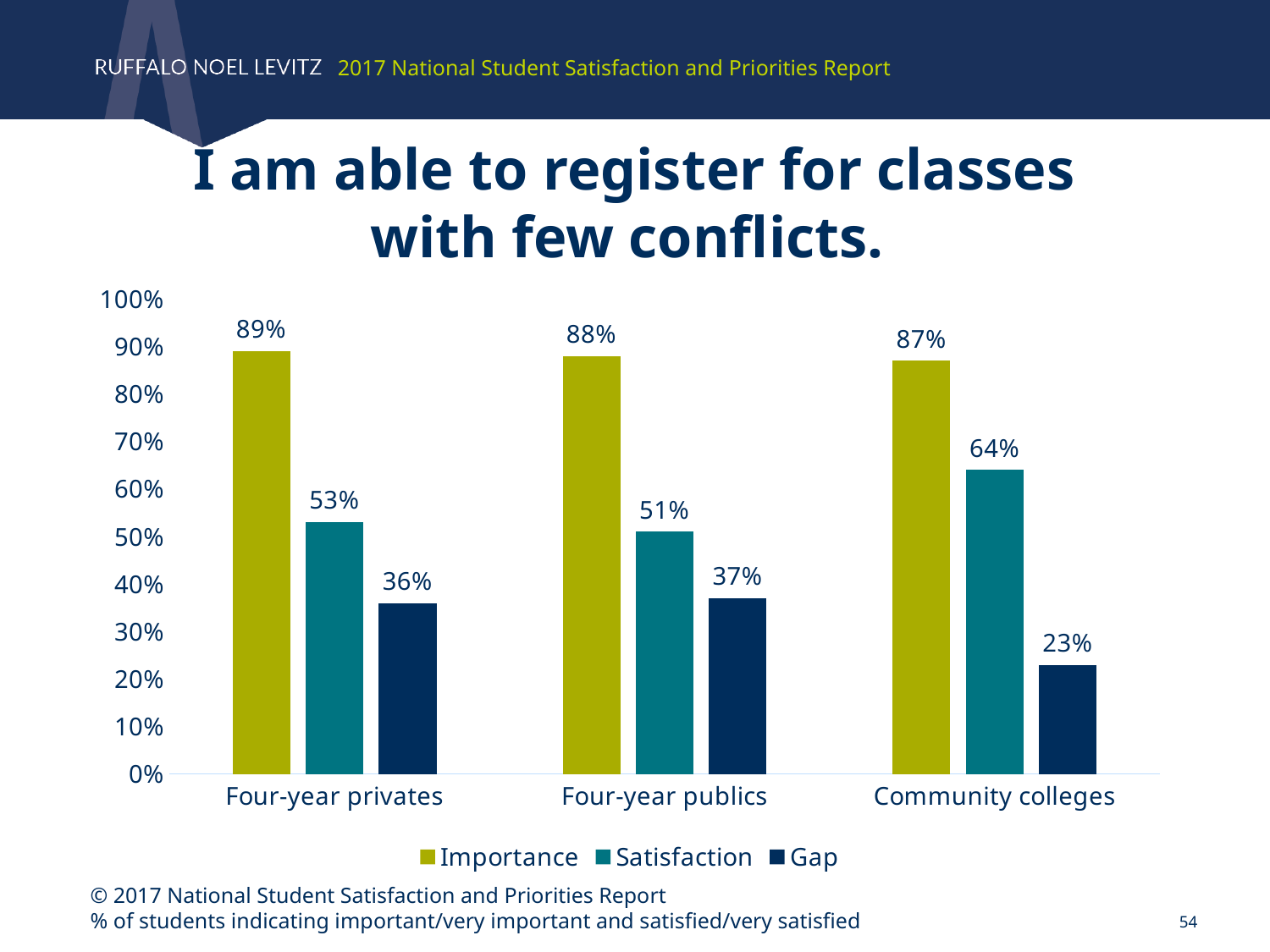
What kind of chart is shown on the slide? bar chart How many categories are shown on the x axis? 3 Is the Gap value for Four-year privates greater or less than 40%? less Which category has the lowest Gap value? Community colleges What is the title of the chart? I am able to register for classes with few conflicts. What is the difference between the Importance and Satisfaction values for Four-year publics? 37% Is the Satisfaction value larger for Four-year privates or Four-year publics? Four-year privates What is the Importance value for Four-year privates? 89% What is the Gap value for Four-year publics? 37% How many series does the legend list? 3 What is the Satisfaction value for Community colleges? 64% Which category has the highest Satisfaction value? Community colleges